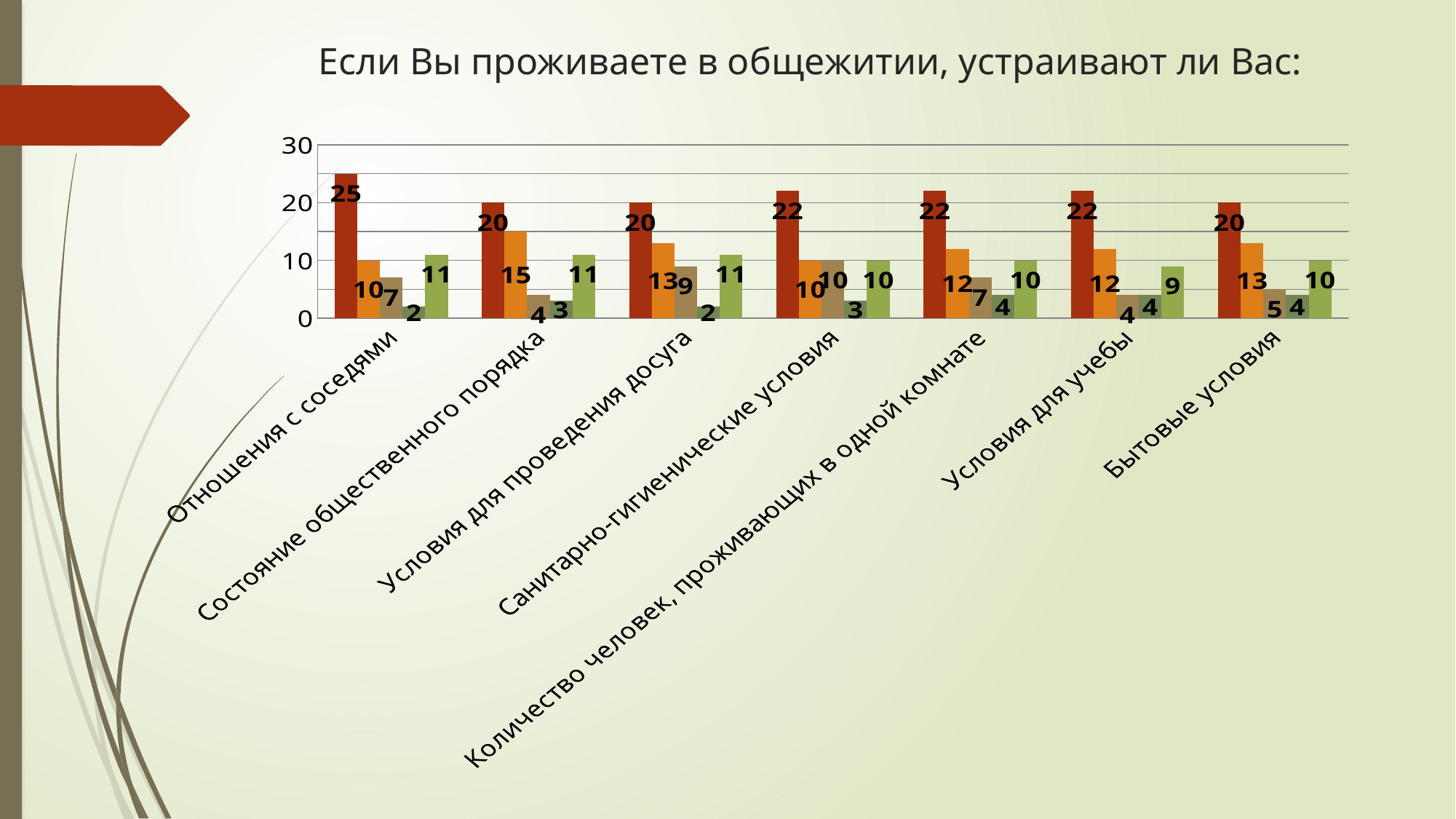
What is the value of the light green bar for "Условия для учебы"? 9 For "Санитарно-гигиенические условия", which is larger: the dark red bar or the light green bar? the dark red bar What is the value of the dark red bar for "Отношения с соседями"? 25 Which category has the highest dark red bar? Отношения с соседями How many categories are shown along the x axis of the chart? 7 What is the difference between the dark red bar and the orange bar for "Бытовые условия"? 7 What kind of chart is shown on the slide? bar chart What is the title of the slide above the chart? Если Вы проживаете в общежитии, устраивают ли Вас: Is the value of the dark red bar for "Количество человек, проживающих в одной комнате" greater or less than 20? greater What is the value of the orange bar for "Состояние общественного порядка"? 15 What is the value of the tan (light brown) bar for "Условия для проведения досуга"? 9